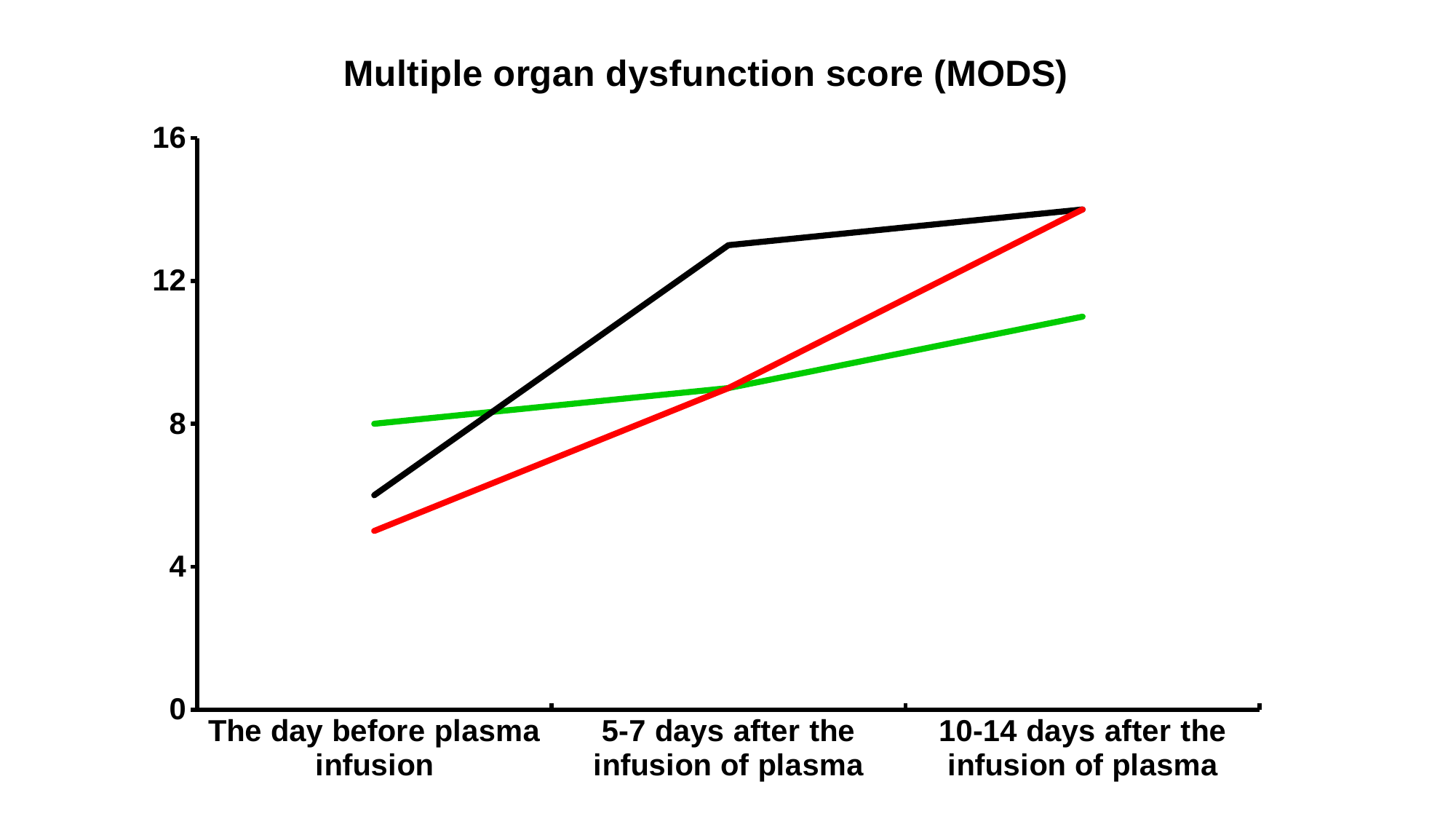
How many time points are shown on the x axis? 3 Does the red line rise or fall from the day before plasma infusion to 10-14 days after the infusion of plasma? rise What is the title of the chart? Multiple organ dysfunction score (MODS) Is the value of the black line at 5-7 days after the infusion of plasma greater or less than 12? greater What kind of chart is shown on the slide? line chart Which line has the lowest value on the day before plasma infusion? the red line Which line has the highest value at 5-7 days after the infusion of plasma? the black line Is the value of the green line at 10-14 days after the infusion of plasma greater or less than 12? less What is the value of the green line on the day before plasma infusion? 8 How many lines are plotted on the chart? 3 At 10-14 days after the infusion of plasma, is the value of the green line larger or smaller than the value of the black line? smaller Is the value of the red line on the day before plasma infusion greater or less than 8? less